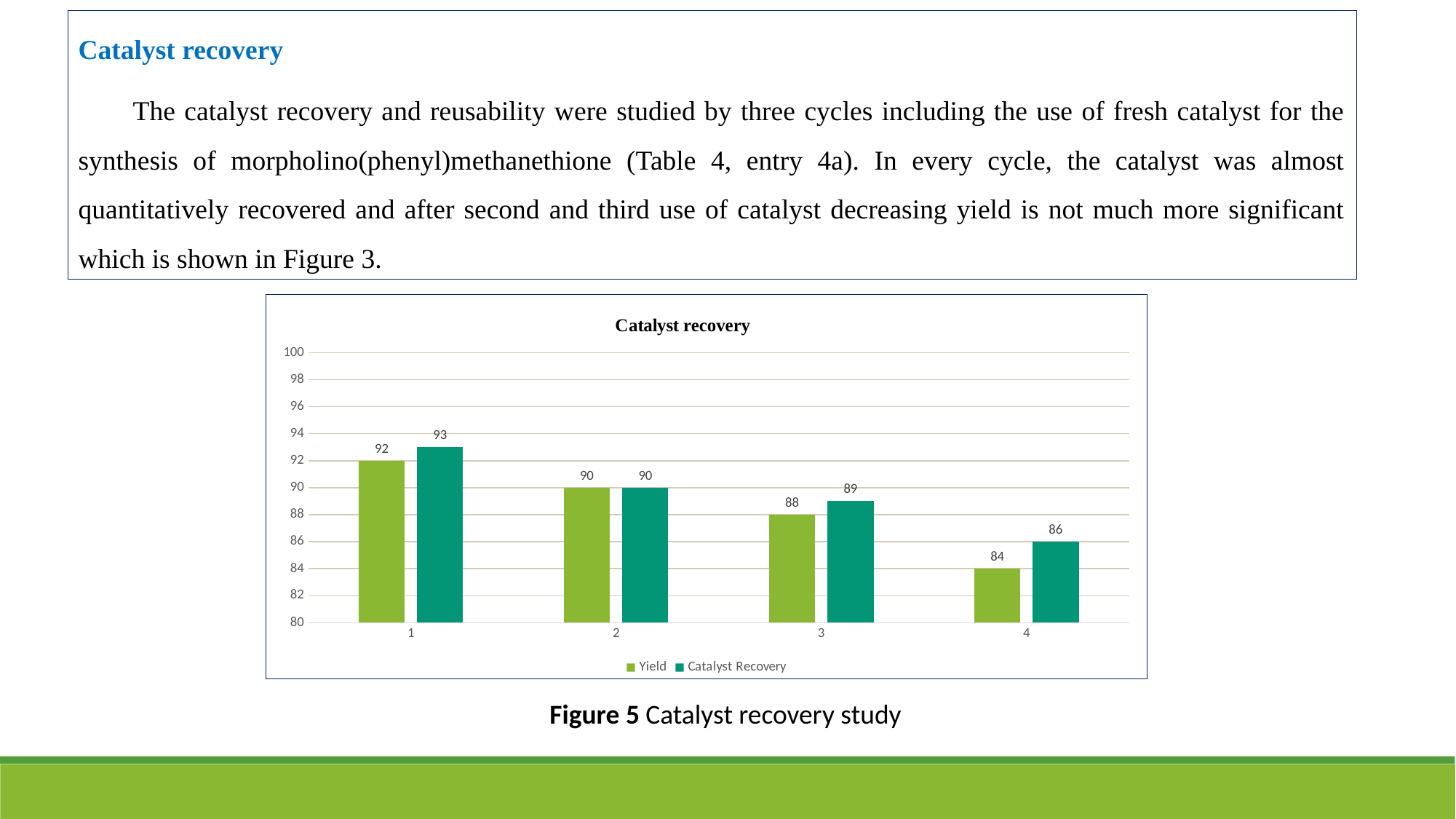
What is the Catalyst Recovery value for category 4? 86 What kind of chart is shown? Bar chart What is the difference between Catalyst Recovery and Yield for category 3? 1 Which is larger for category 4, Yield or Catalyst Recovery? Catalyst Recovery How many series does the legend list? 2 Which category has the highest Catalyst Recovery value? 1 Which category has the lowest Yield value? 4 How many categories are shown on the x axis? 4 What is the Catalyst Recovery value for category 3? 89 Do the Yield values rise or fall from category 1 to category 4? Fall What is the difference between the Yield values for category 1 and category 4? 8 What is the Yield value for category 1? 92